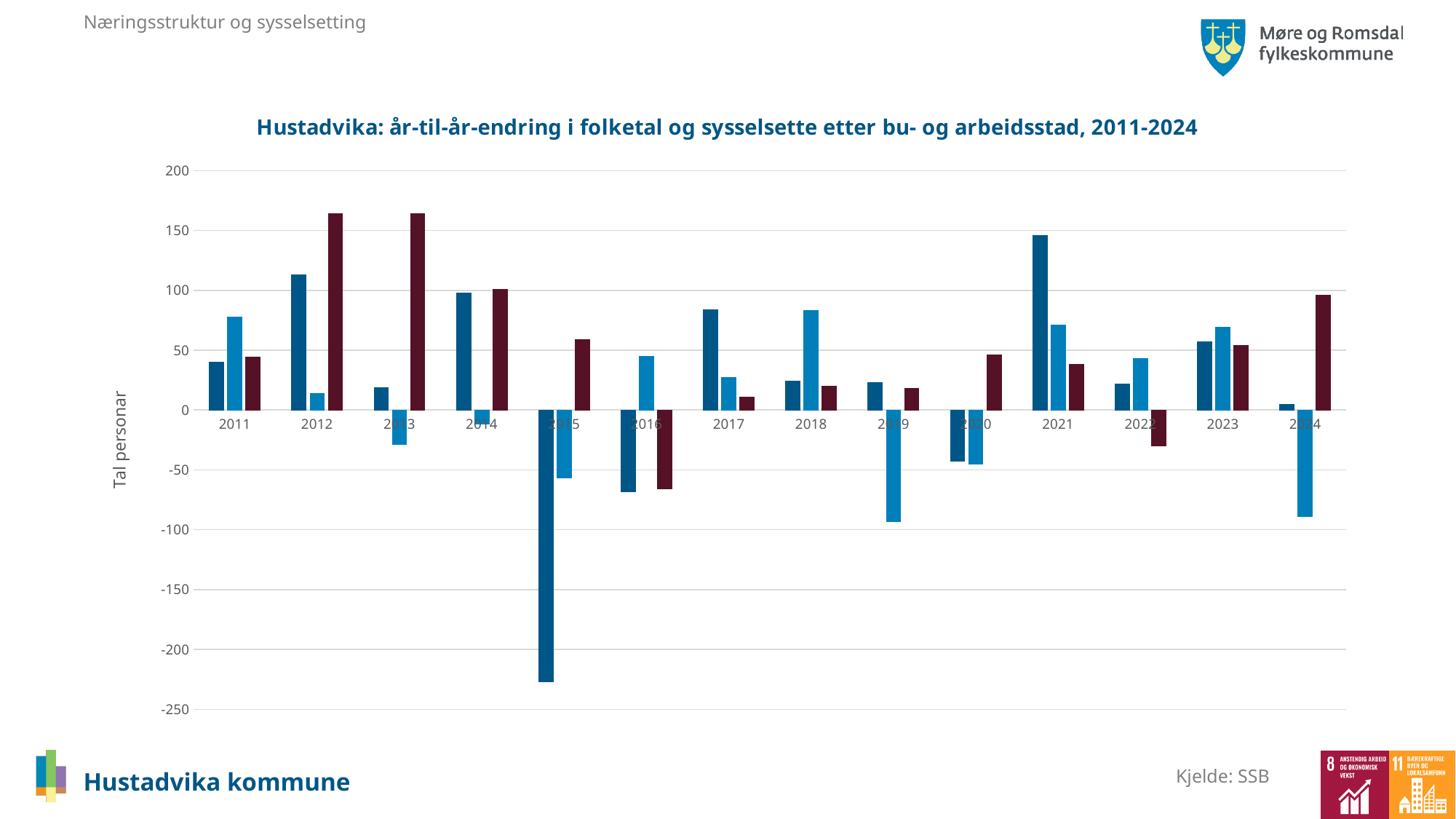
Is the value of the light blue bar for 2024 greater or less than -50? less Is the value of the dark blue bar for 2015 greater or less than -200? less How many years are shown along the x axis of the chart? 14 What kind of chart is shown on the slide? bar chart In which year is the dark blue bar highest? 2021 Is the value of the dark red bar for 2012 greater or less than 150? greater Which is larger: the dark red bar for 2023 or the dark red bar for 2024? 2024 What is the label on the vertical axis of the chart? Tal personar What is the title of the chart? Hustadvika: år-til-år-endring i folketal og sysselsette etter bu- og arbeidsstad, 2011-2024 In which year is the dark blue bar lowest? 2015 How many bars are plotted for each year in the chart? 3